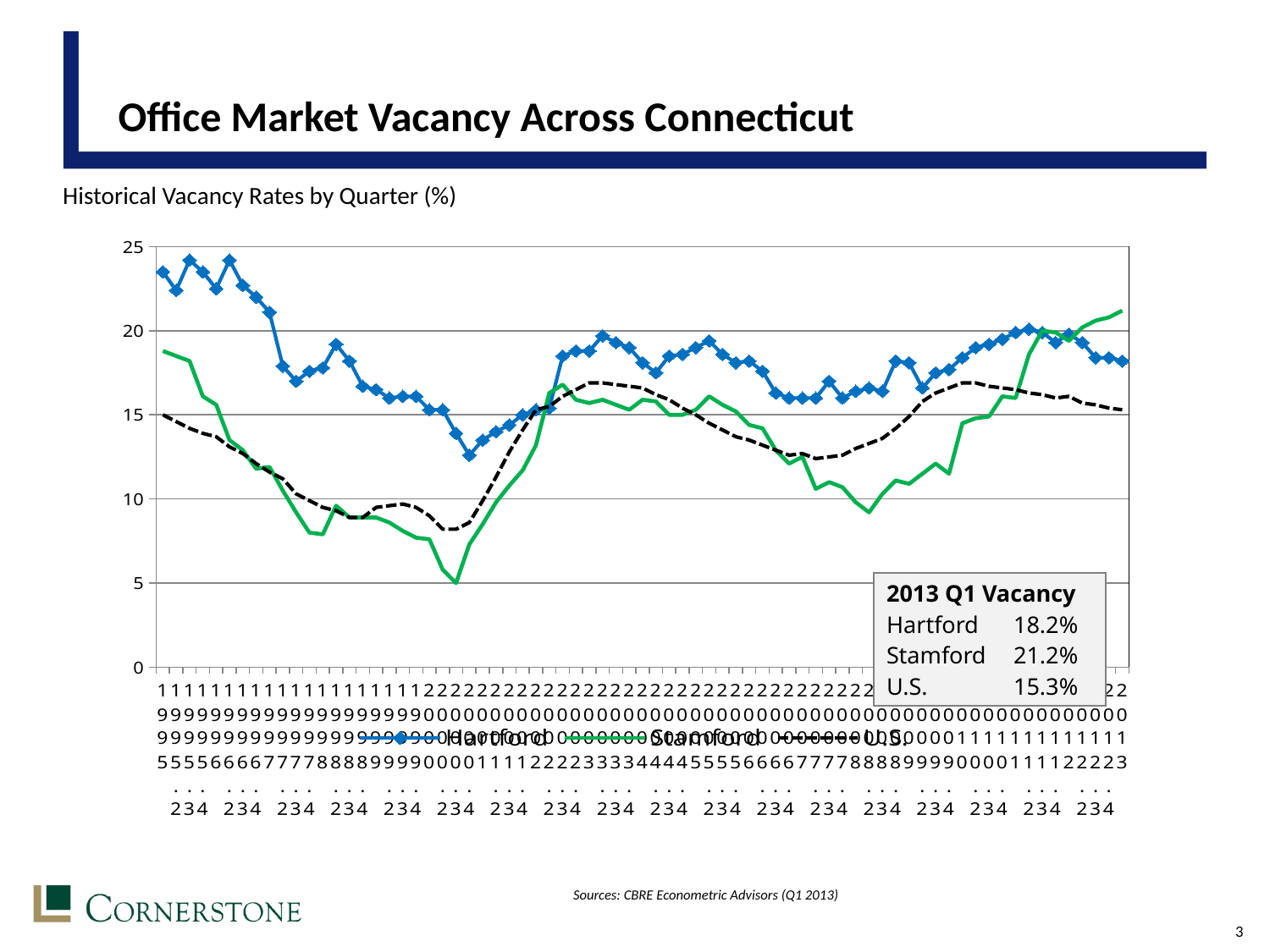
According to the 2013 Q1 Vacancy box, what is the vacancy rate for Stamford? 21.2% Is the lowest point of the Stamford line greater or less than 10? less What is the title of the chart? Historical Vacancy Rates by Quarter (%) What is the difference between the Stamford and Hartford vacancy rates in 2013 Q1? 3.0 percentage points According to the 2013 Q1 Vacancy box, what is the vacancy rate for Hartford? 18.2% How many series does the legend list? 3 According to the 2013 Q1 Vacancy box, what is the U.S. vacancy rate? 15.3% Which of the three series has the lowest vacancy rate in 2013 Q1? U.S. What kind of chart is shown on the slide? line chart In 2013 Q1, is the Hartford vacancy rate higher or lower than the U.S. rate? higher Is the highest point of the Hartford line greater or less than 20? greater Which market has the highest vacancy rate in 2013 Q1? Stamford